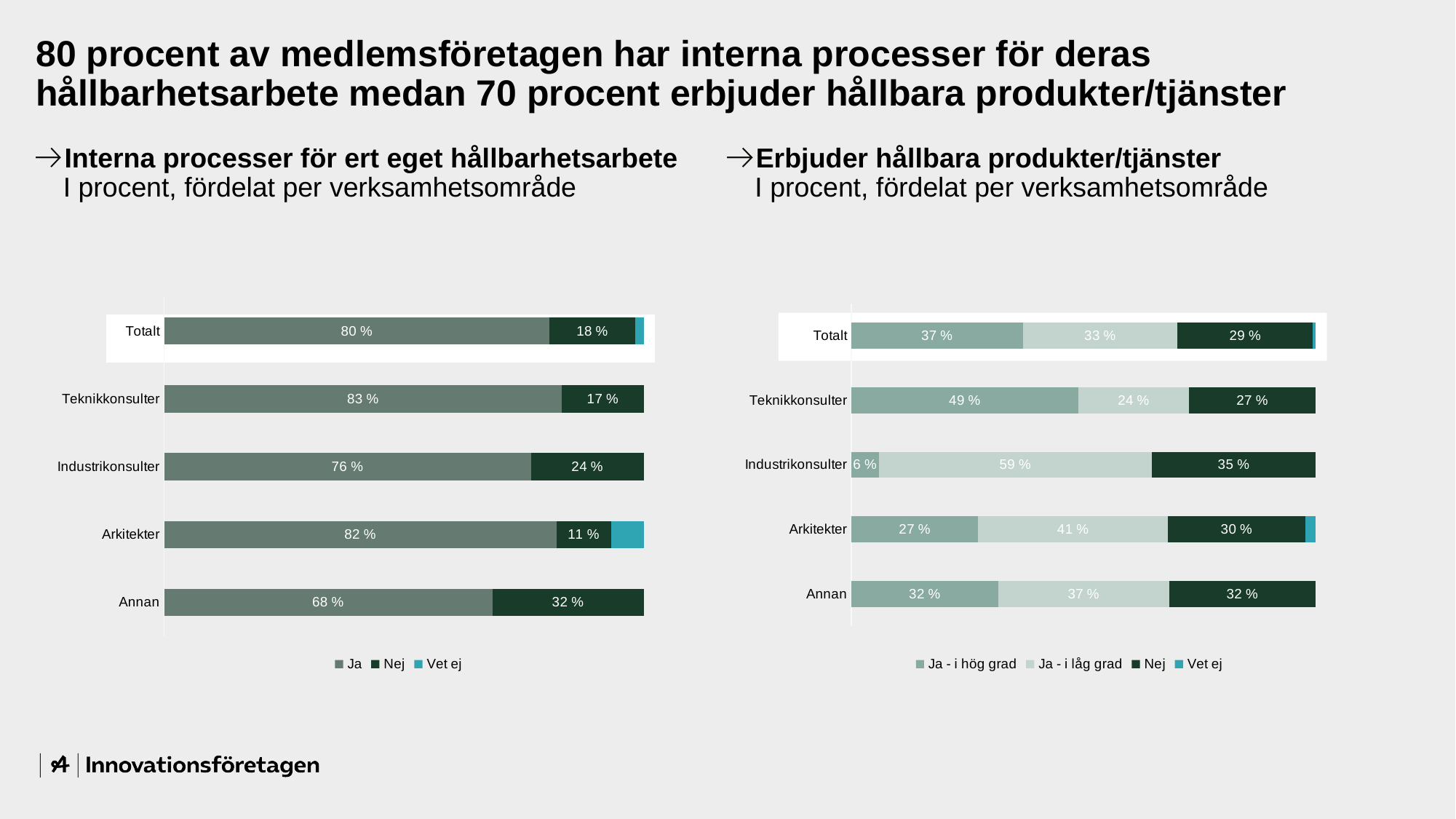
In the chart 'Erbjuder hållbara produkter/tjänster', what is the 'Nej' value for Totalt? 29 % In the chart 'Interna processer för ert eget hållbarhetsarbete', which category has the highest 'Ja' value? Teknikkonsulter In the chart 'Interna processer för ert eget hållbarhetsarbete', which category has the lowest 'Ja' value? Annan In the chart 'Erbjuder hållbara produkter/tjänster', is the 'Nej' value for Industrikonsulter larger or smaller than the 'Nej' value for Teknikkonsulter? larger In the chart 'Interna processer för ert eget hållbarhetsarbete', what is the 'Ja' value for Teknikkonsulter? 83 % In the chart 'Erbjuder hållbara produkter/tjänster', what is the 'Ja - i låg grad' value for Industrikonsulter? 59 % In the chart 'Interna processer för ert eget hållbarhetsarbete', what is the 'Nej' value for Annan? 32 % How many categories are shown in the chart 'Erbjuder hållbara produkter/tjänster'? 5 How many series does the legend of the chart 'Interna processer för ert eget hållbarhetsarbete' list? 3 In the chart 'Interna processer för ert eget hållbarhetsarbete', what is the difference between the 'Ja' values for Arkitekter and Industrikonsulter? 6 % In the chart 'Erbjuder hållbara produkter/tjänster', which category has the highest 'Ja - i hög grad' value? Teknikkonsulter What kind of chart is 'Erbjuder hållbara produkter/tjänster'? Stacked bar chart